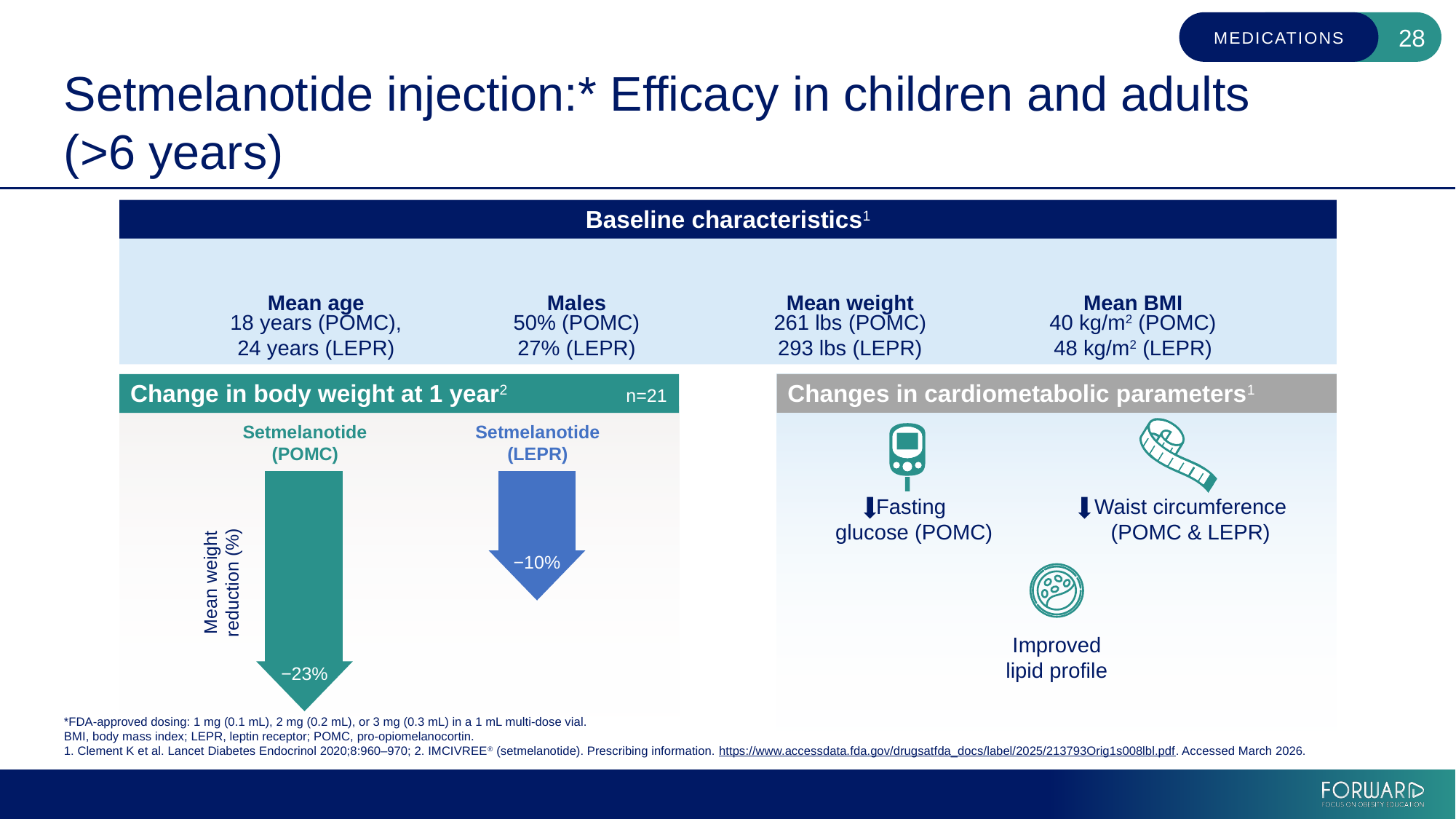
What is the vertical axis label of the 'Change in body weight at 1 year' chart? Mean weight reduction (%) In the 'Change in body weight at 1 year' chart, which group shows the smaller mean weight reduction? Setmelanotide (LEPR) In the 'Change in body weight at 1 year' chart, is the weight reduction for Setmelanotide (POMC) larger or smaller than for Setmelanotide (LEPR)? Larger In the 'Change in body weight at 1 year' chart, what is the mean weight reduction for Setmelanotide (LEPR)? −10% In the 'Change in body weight at 1 year' chart, what is the mean weight reduction for Setmelanotide (POMC)? −23% What sample size (n) is shown in the header of the 'Change in body weight at 1 year' chart? n=21 In the 'Change in body weight at 1 year' chart, by how many percentage points does the weight reduction for POMC exceed that for LEPR? 13 percentage points How many groups are shown in the 'Change in body weight at 1 year' chart? 2 In the 'Change in body weight at 1 year' chart, which group shows the larger mean weight reduction? Setmelanotide (POMC)